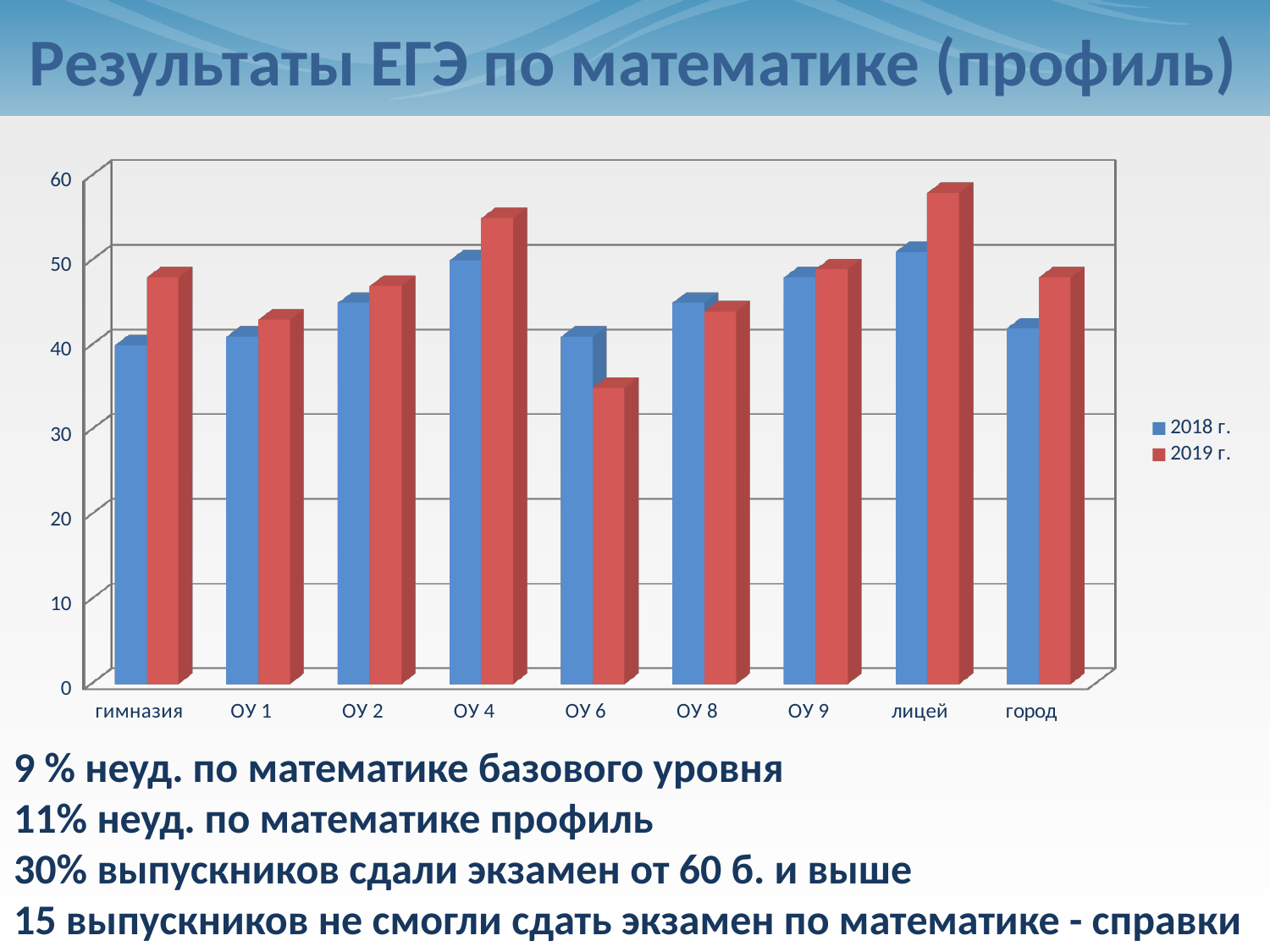
Is the 2018 г. value for ОУ 2 greater or less than 50? less Is the 2019 г. value for лицей greater or less than 50? greater What kind of chart is shown on the slide? bar chart Is the 2019 г. value for ОУ 4 greater or less than 50? greater Which category has the highest value for 2019 г.? лицей Which category has the lowest value for 2019 г.? ОУ 6 How many series does the legend list? 2 For ОУ 6, which series has the larger value, 2018 г. or 2019 г.? 2018 г. Which has the larger 2019 г. value, ОУ 4 or ОУ 1? ОУ 4 What are the two entries in the chart legend? 2018 г. and 2019 г. How many categories are shown on the x axis? 9